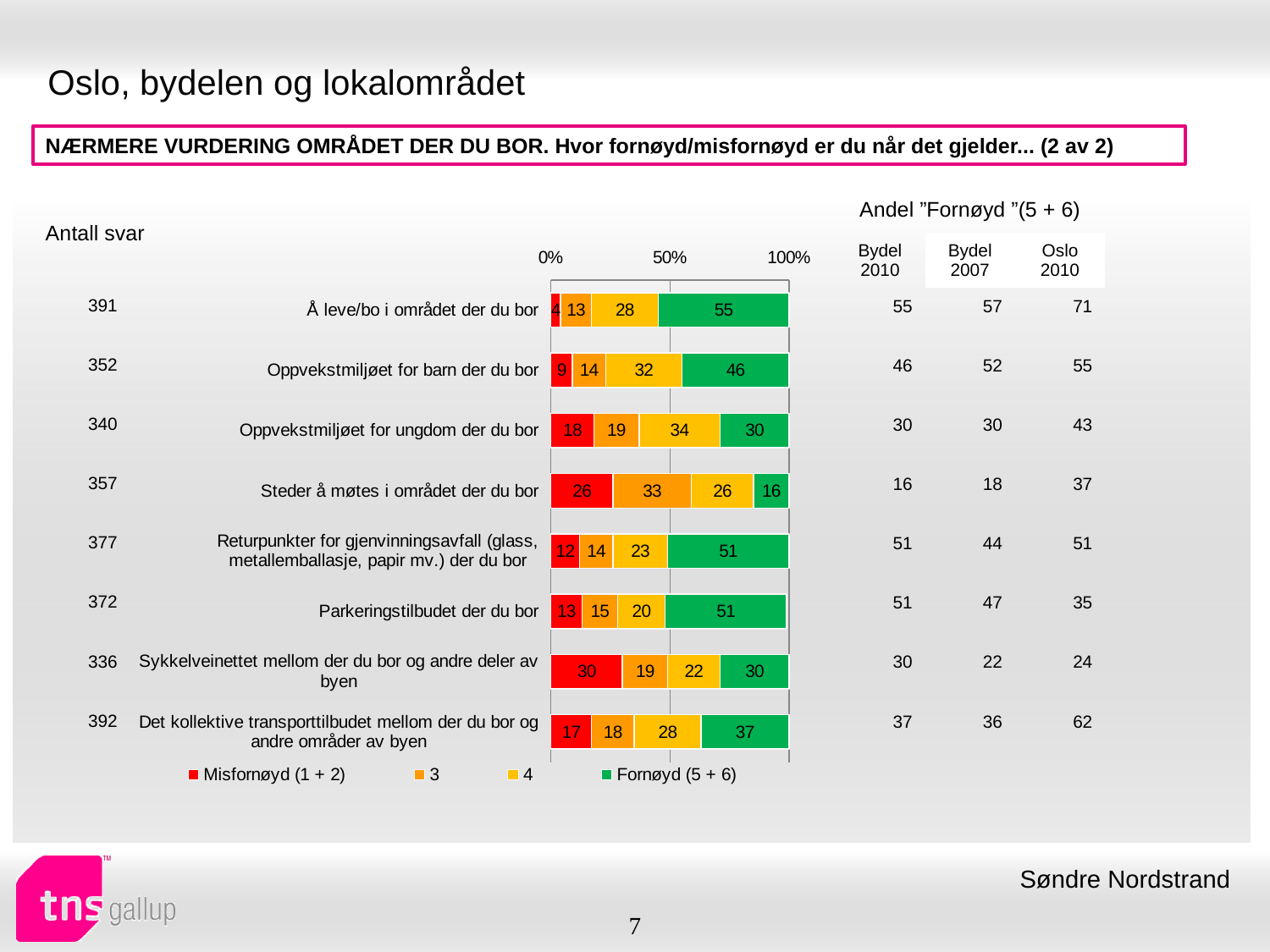
Which legend entry is shown in green? Fornøyd (5 + 6) Which category has the highest Fornøyd (5 + 6) value? Å leve/bo i området der du bor What kind of chart is shown on the slide? Stacked bar chart What is the Misfornøyd (1 + 2) value for 'Steder å møtes i området der du bor'? 26 What is the difference between the Fornøyd (5 + 6) values for 'Oppvekstmiljøet for barn der du bor' and 'Oppvekstmiljøet for ungdom der du bor'? 16 What is the Fornøyd (5 + 6) value for 'Å leve/bo i området der du bor'? 55 Which category has the lowest Fornøyd (5 + 6) value? Steder å møtes i området der du bor How many categories (rows) does the bar chart show? 8 Which has the larger Misfornøyd (1 + 2) value: 'Sykkelveinettet mellom der du bor og andre deler av byen' or 'Parkeringstilbudet der du bor'? Sykkelveinettet mellom der du bor og andre deler av byen What is the value of series '4' for 'Oppvekstmiljøet for ungdom der du bor'? 34 How many series does the chart legend list? 4 What is the total of the stacked bar for 'Å leve/bo i området der du bor'? 100